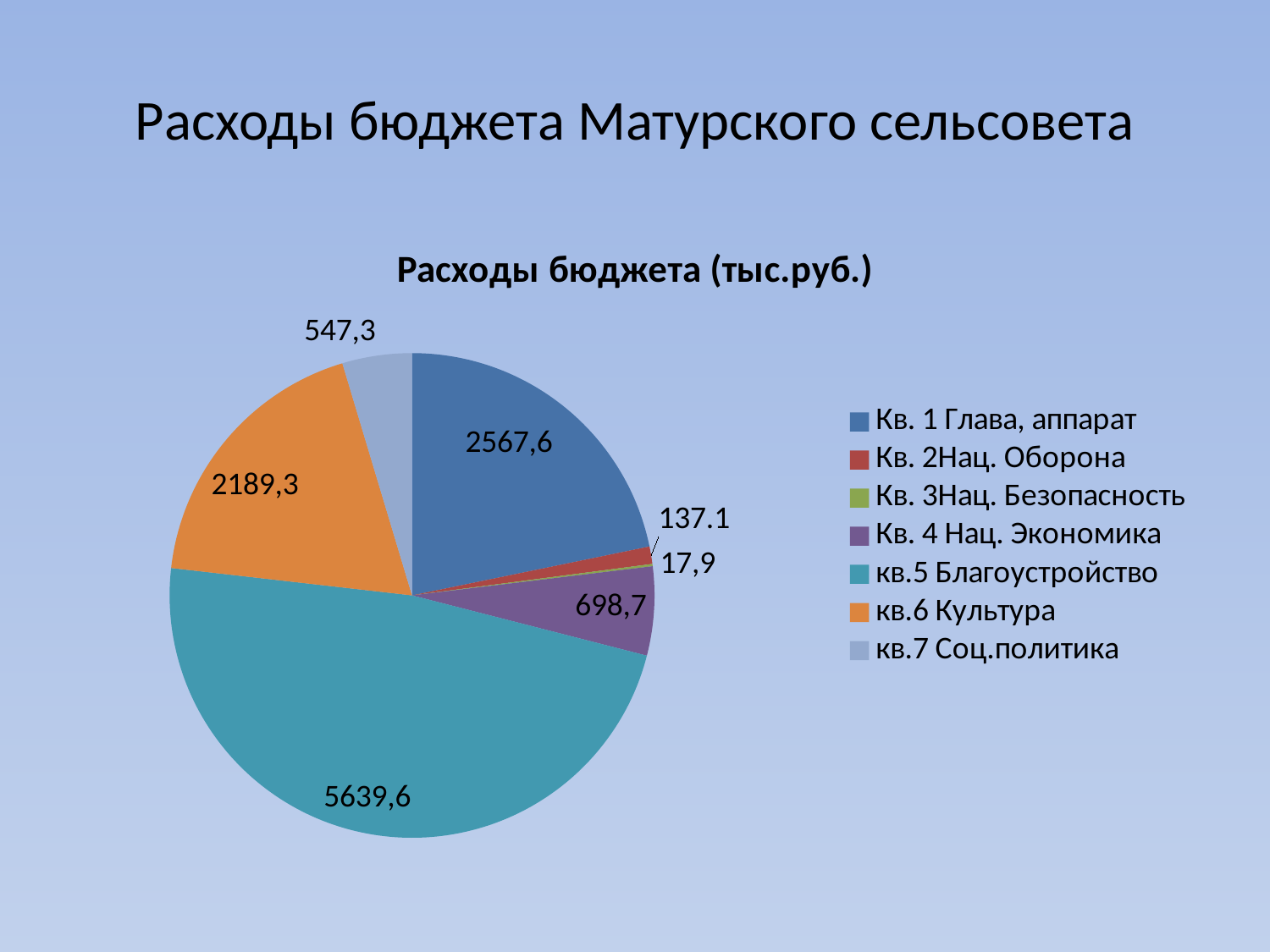
What is the difference between the values for кв.5 Благоустройство and Кв. 1 Глава, аппарат? 3072,0 What is the value for Кв. 4 Нац. Экономика? 698,7 What is the value for кв.7 Соц.политика? 547,3 Which category has the smallest slice of the pie? Кв. 3Нац. Безопасность Which is larger, the value for кв.6 Культура or the value for Кв. 1 Глава, аппарат? Кв. 1 Глава, аппарат Which category has the largest slice of the pie? кв.5 Благоустройство What is the value for Кв. 1 Глава, аппарат? 2567,6 How many categories does the legend list? 7 What is the value for Кв. 2Нац. Оборона? 137.1 What is the value for кв.5 Благоустройство? 5639,6 What kind of chart is shown on the slide? pie chart What is the value for кв.6 Культура? 2189,3